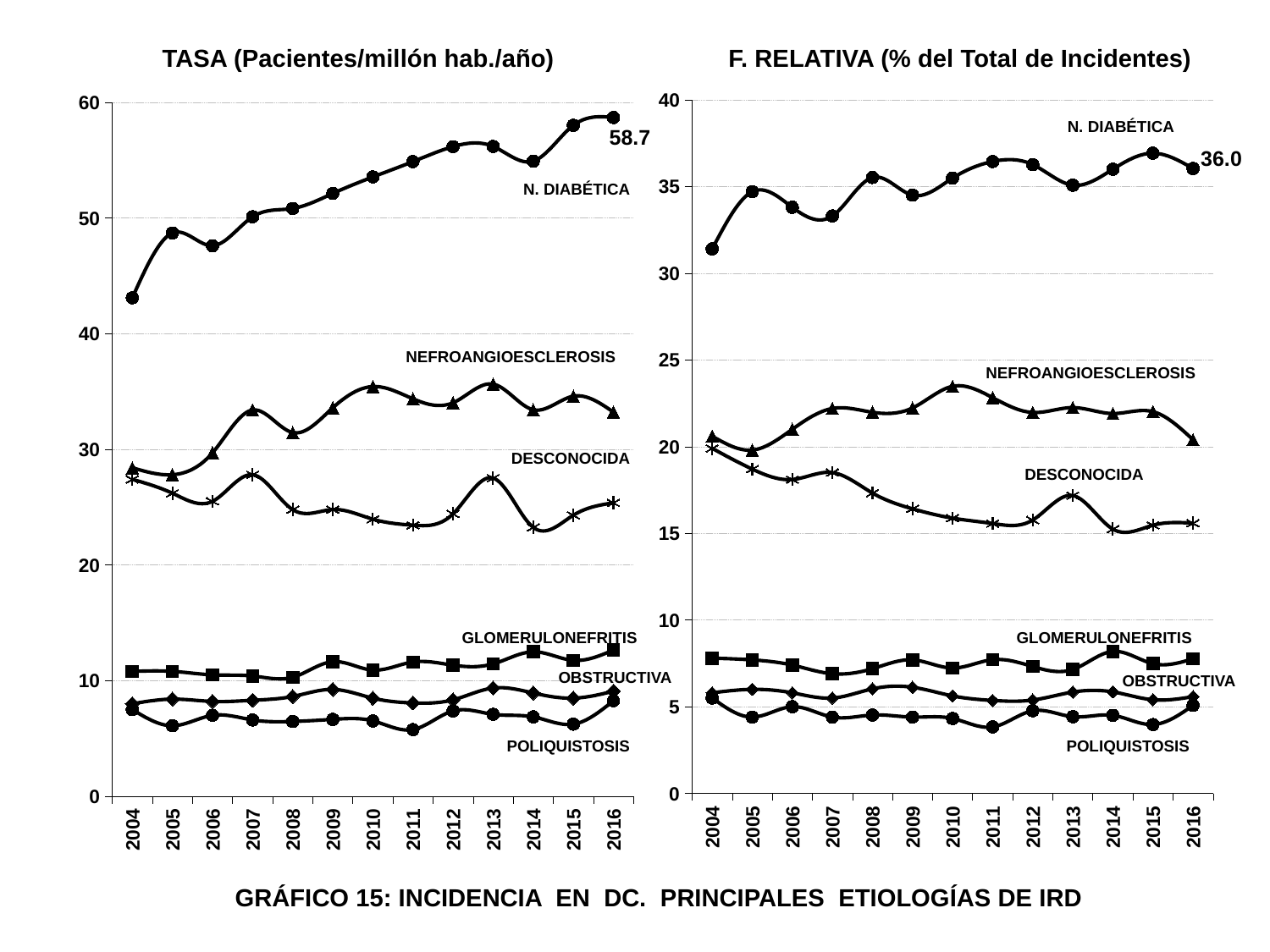
In the TASA (Pacientes/millón hab./año) chart, what is the labelled value for N. DIABÉTICA in 2016? 58.7 How many years are plotted along the x axis of the F. RELATIVA chart? 13 In the TASA (Pacientes/millón hab./año) chart, which etiology has the lowest value in 2011? POLIQUISTOSIS What kind of chart is the TASA (Pacientes/millón hab./año) chart? Line chart In the TASA (Pacientes/millón hab./año) chart, does the N. DIABÉTICA line generally rise or fall from 2004 to 2016? Rise How many etiology series are labelled in the TASA (Pacientes/millón hab./año) chart? 6 In the TASA (Pacientes/millón hab./año) chart, is the value for N. DIABÉTICA in 2004 greater or less than 40? greater What is the title of the left-hand chart on the slide? TASA (Pacientes/millón hab./año) In the F. RELATIVA (% del Total de Incidentes) chart, which is larger in 2010: NEFROANGIOESCLEROSIS or DESCONOCIDA? NEFROANGIOESCLEROSIS In the F. RELATIVA (% del Total de Incidentes) chart, is the value for DESCONOCIDA in 2016 greater or less than 20? less In the TASA (Pacientes/millón hab./año) chart, which etiology has the highest value in 2016? N. DIABÉTICA In the F. RELATIVA (% del Total de Incidentes) chart, what is the labelled value for N. DIABÉTICA in 2016? 36.0